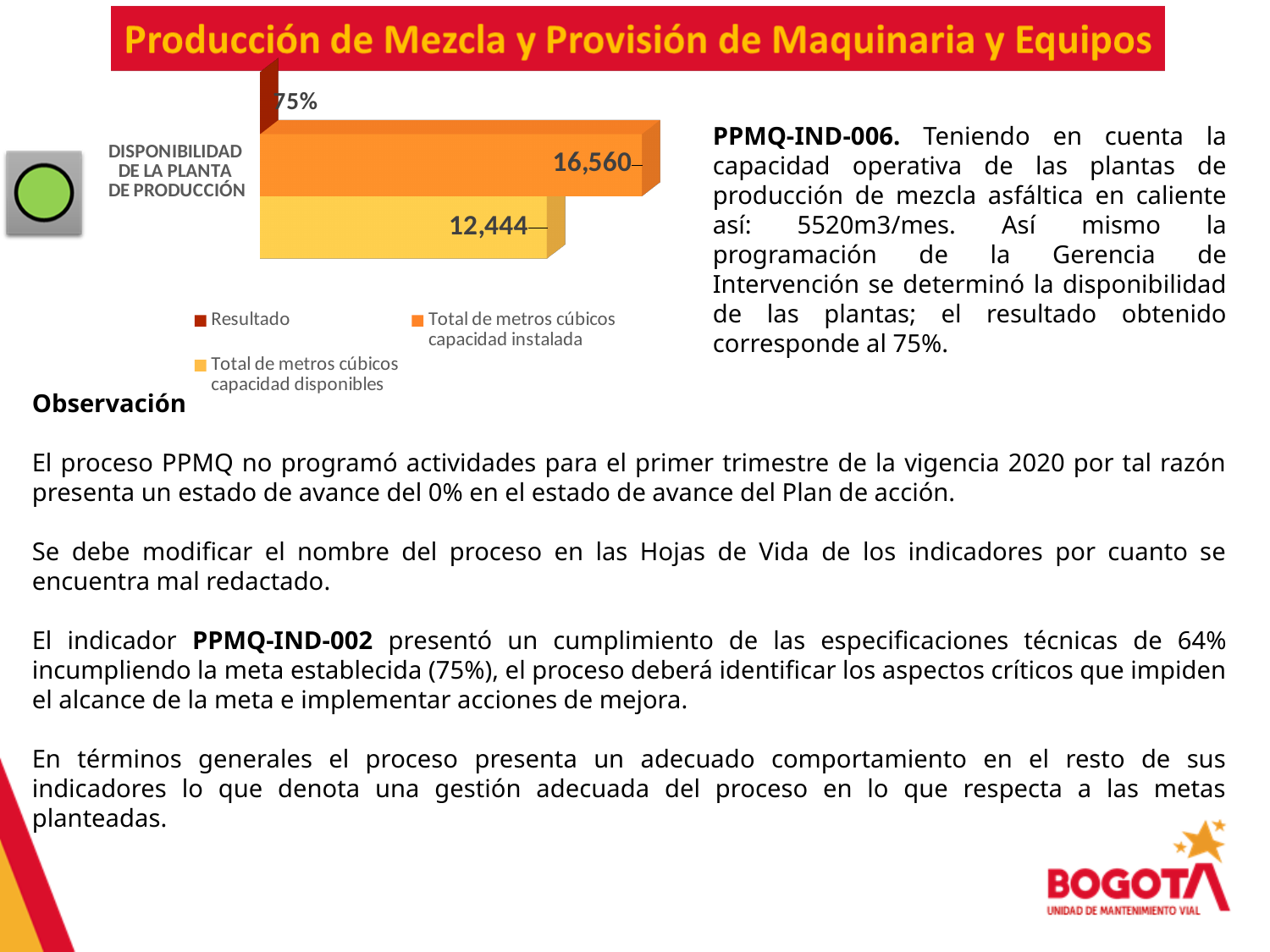
How many series does the chart legend list? 3 What value is shown for the series "Total de metros cúbicos capacidad instalada"? 16,560 Which is larger, the capacidad instalada bar or the capacidad disponibles bar? Total de metros cúbicos capacidad instalada What kind of chart is shown on the slide? Bar chart What is the category label shown next to the chart bars? DISPONIBILIDAD DE LA PLANTA DE PRODUCCIÓN How many categories are plotted in the chart? 1 What value is shown for the "Resultado" series? 75% What is the difference between the capacidad instalada value and the capacidad disponibles value? 4,116 Which legend entry is shown in dark red? Resultado What value is shown for the series "Total de metros cúbicos capacidad disponibles"? 12,444